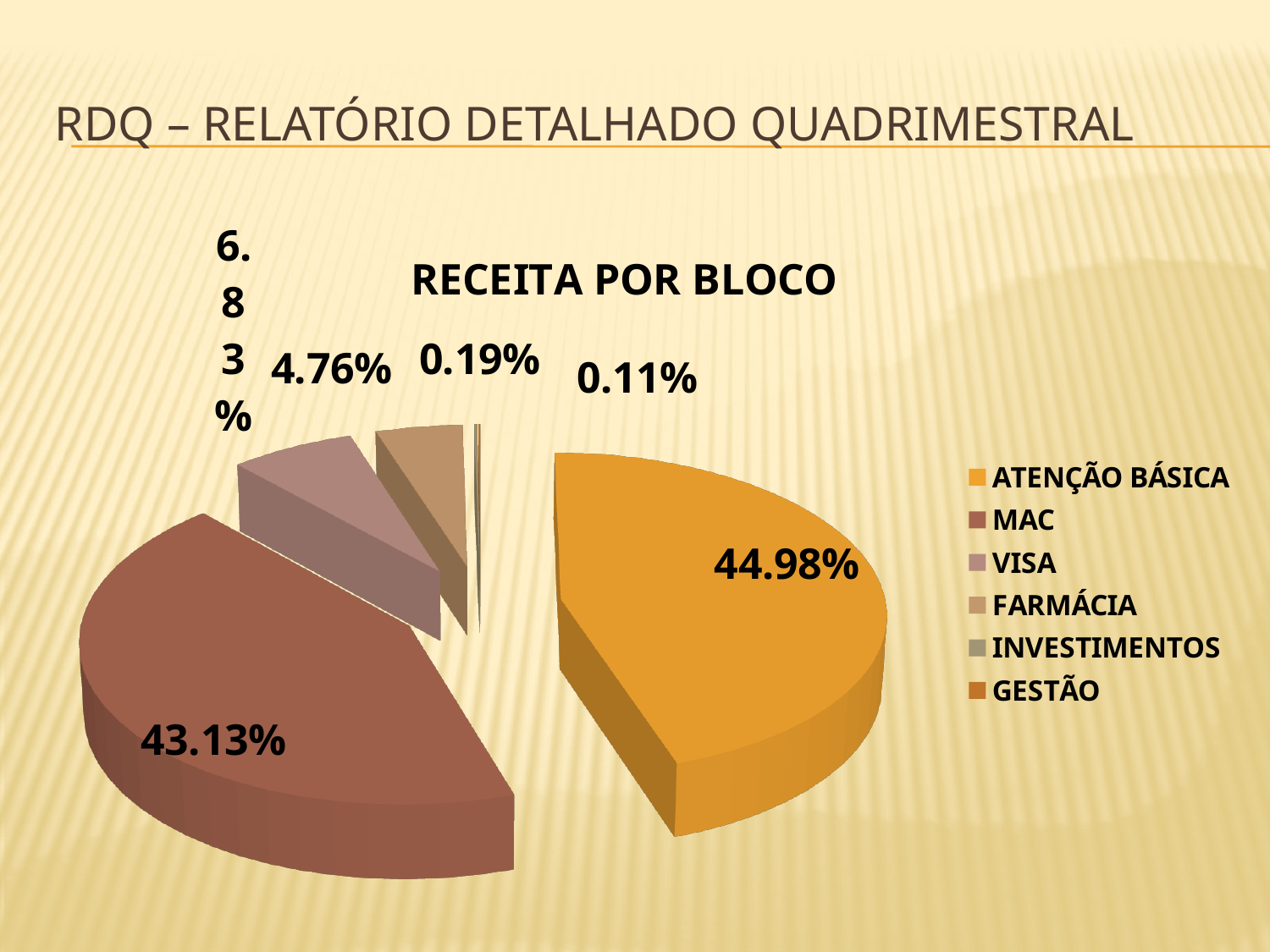
What is the difference between the shares of INVESTIMENTOS and GESTÃO? 0.08% How many categories does the legend of the pie chart list? 6 What type of chart is shown on the slide? pie chart Which category has the largest share of the pie? ATENÇÃO BÁSICA Which category has the smallest share of the pie? GESTÃO What share of the pie does FARMÁCIA have? 4.76% What share of the pie does VISA have? 6.83% What is the title of the chart? RECEITA POR BLOCO What is the difference between the shares of ATENÇÃO BÁSICA and MAC? 1.85% Which has a larger share, VISA or FARMÁCIA? VISA What share of the pie does MAC have? 43.13%